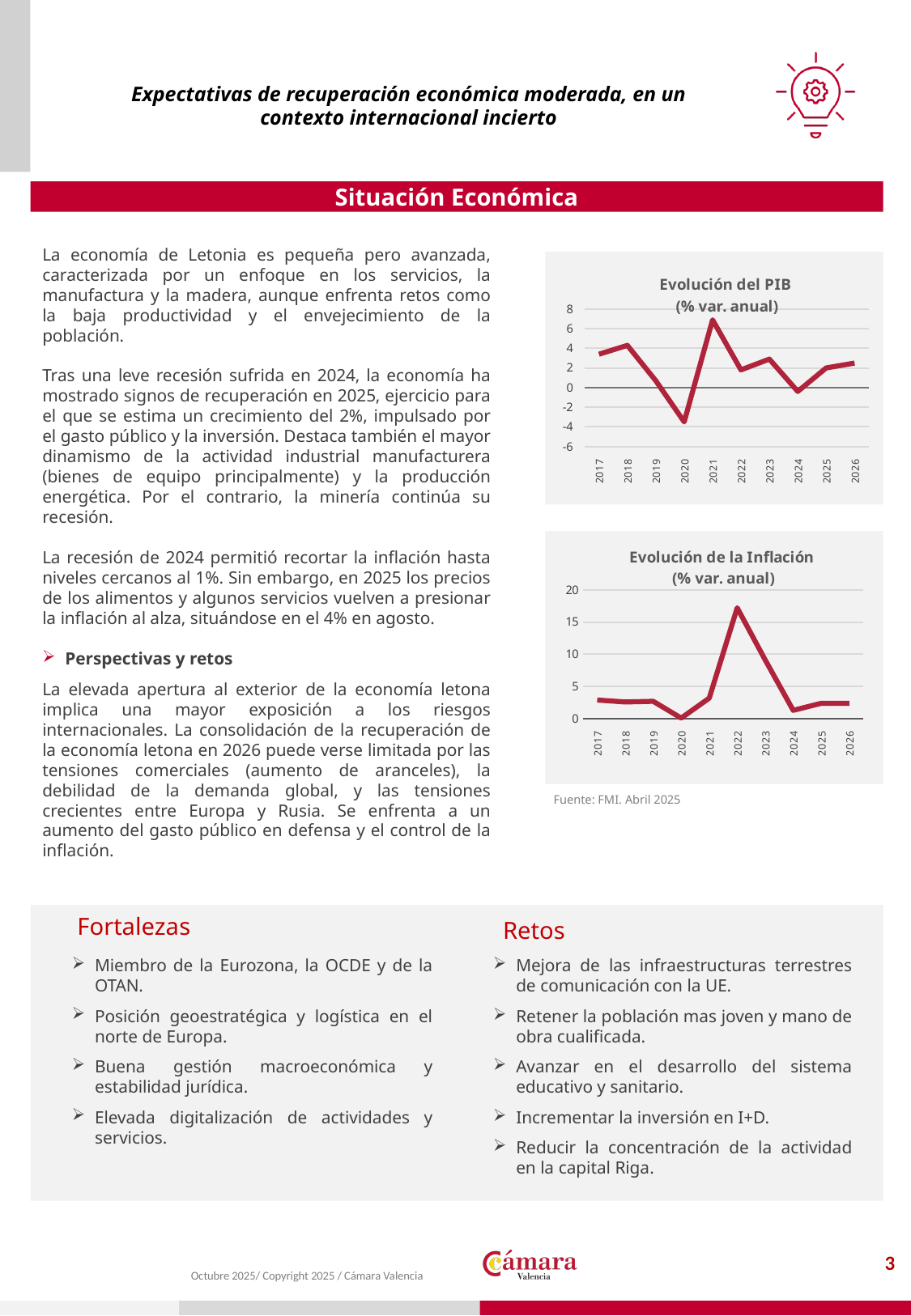
In the 'Evolución de la Inflación' chart, which year has the highest value? 2022 In the 'Evolución de la Inflación' chart, is the value for 2024 greater or less than 5? less What kind of chart is the 'Evolución del PIB' chart? line chart In the 'Evolución del PIB' chart, which year has the lowest value? 2020 In the 'Evolución de la Inflación' chart, do the values rise or fall from 2022 to 2024? fall In the 'Evolución de la Inflación' chart, is the value for 2022 greater or less than 15? greater In the 'Evolución del PIB' chart, is the value for 2020 greater or less than -2? less How many years are plotted on the x axis of the 'Evolución del PIB' chart? 10 In the 'Evolución de la Inflación' chart, which year has the lowest value? 2020 In the 'Evolución del PIB' chart, which year has the highest value? 2021 In the 'Evolución del PIB' chart, do the values rise or fall from 2019 to 2020? fall